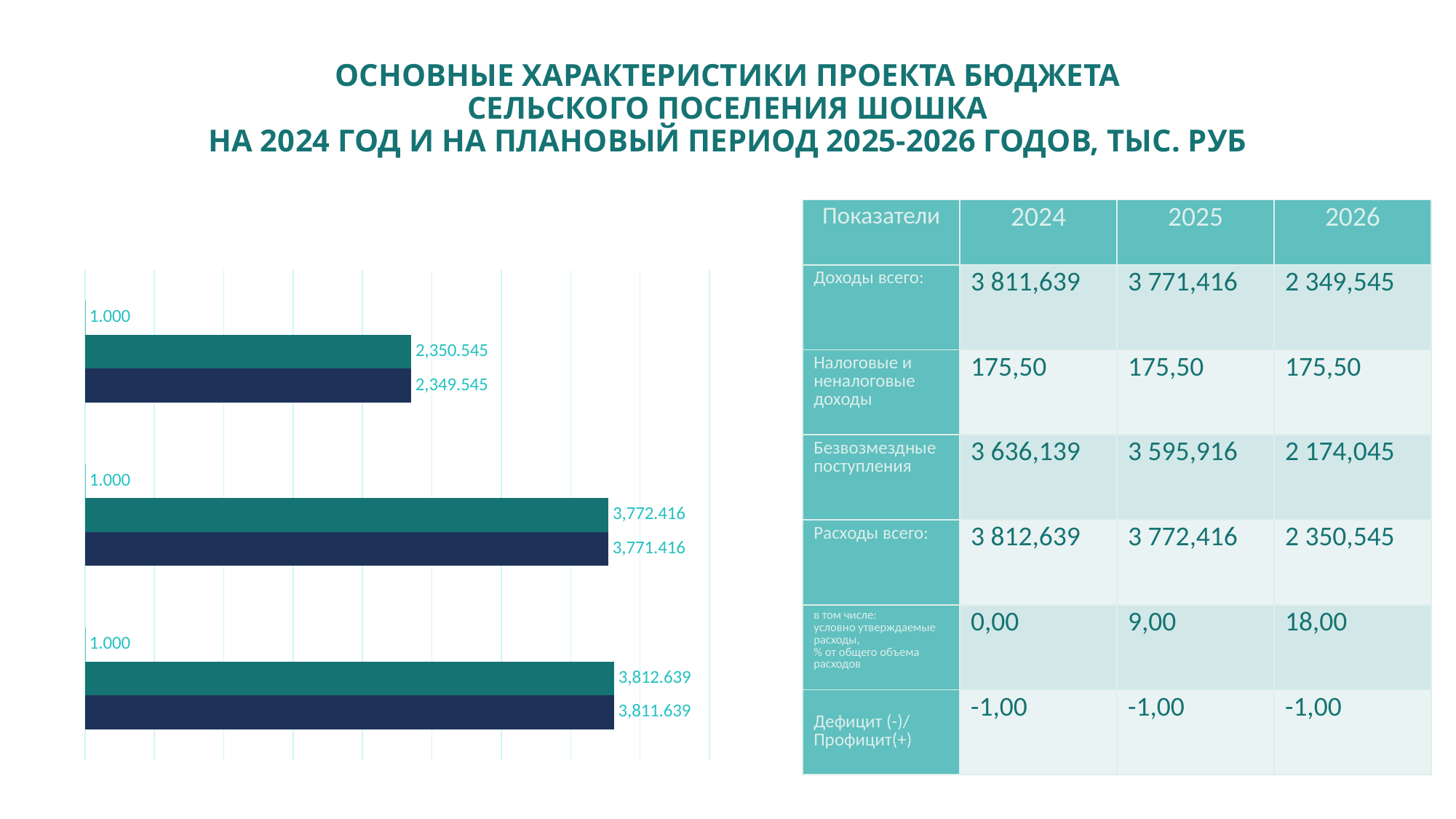
In the chart on the left, what is the value labelled on the teal bar in the bottom group? 3,812.639 What type of chart is shown on the left of the slide? bar chart In the chart on the left, what is the value labelled on the teal bar in the top group? 2,350.545 In the chart on the left, what is the value labelled on the dark navy bar in the middle group? 3,771.416 In the chart on the left, what is the difference between the teal bar in the bottom group and the teal bar in the top group? 1,462.094 How many groups of bars does the chart on the left contain? 3 In the chart on the left, what is the difference between the teal bar and the dark navy bar in the bottom group? 1.000 In the chart on the left, what is the value labelled on the dark navy bar in the bottom group? 3,811.639 In the chart on the left, what value is labelled above the teal bar in each group? 1.000 In the chart on the left, which of the teal and dark navy bars has the smallest value? the dark navy bar in the top group (2,349.545) In the chart on the left, which labelled bar has the largest value? the teal bar in the bottom group (3,812.639) In the chart on the left, which is larger in the middle group: the teal bar or the dark navy bar? the teal bar